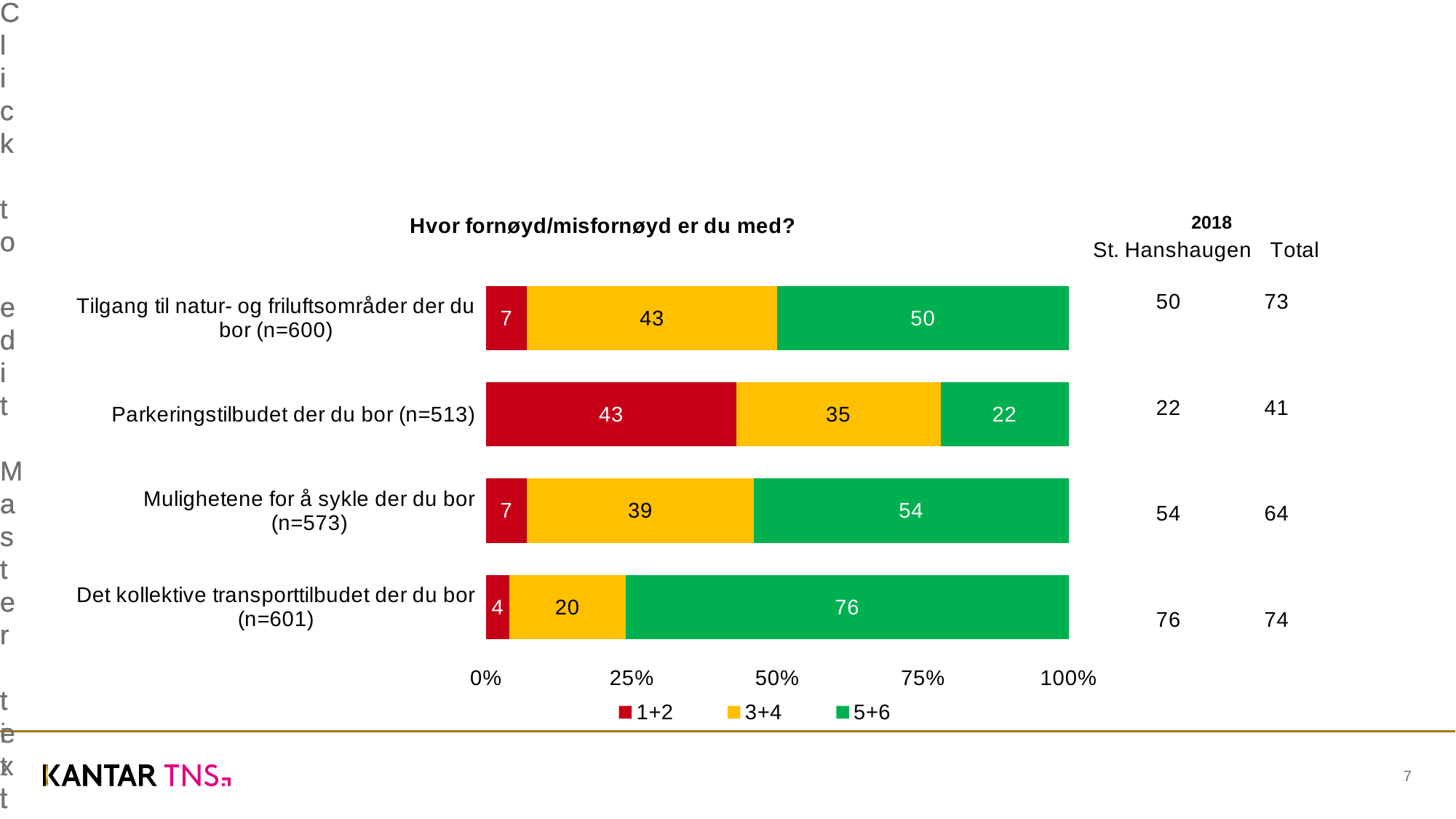
What is the 3+4 value for 'Mulighetene for å sykle der du bor (n=573)'? 39 How many categories are plotted in the chart? 4 What is the title of the chart? Hvor fornøyd/misfornøyd er du med? Which category has the highest 5+6 value? Det kollektive transporttilbudet der du bor (n=601) Which category has the lowest 5+6 value? Parkeringstilbudet der du bor (n=513) What is the total of the stacked bar for 'Parkeringstilbudet der du bor (n=513)'? 100 How many series does the legend list? 3 What is the difference between the 5+6 values for 'Mulighetene for å sykle der du bor (n=573)' and 'Tilgang til natur- og friluftsområder der du bor (n=600)'? 4 Which is larger: the 3+4 value for 'Tilgang til natur- og friluftsområder der du bor (n=600)' or the 3+4 value for 'Parkeringstilbudet der du bor (n=513)'? Tilgang til natur- og friluftsområder der du bor (n=600) What kind of chart is shown on the slide? Stacked bar chart What is the 1+2 value for 'Parkeringstilbudet der du bor (n=513)'? 43 What is the 5+6 value for 'Det kollektive transporttilbudet der du bor (n=601)'? 76